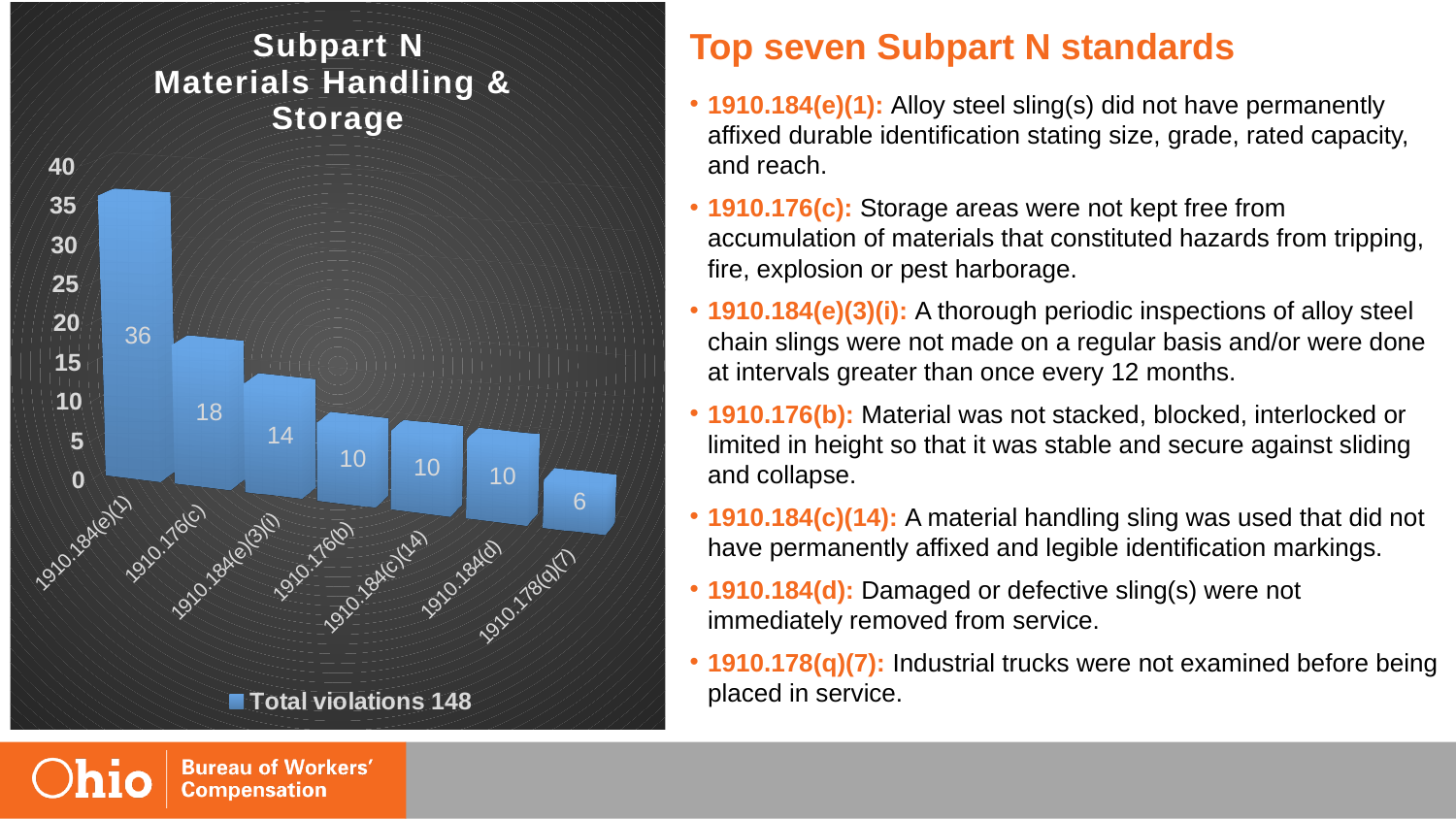
What is the value for 1910.176(c)? 18 Which is larger, the value for 1910.184(e)(3)(i) or the value for 1910.176(b)? 1910.184(e)(3)(i) What is the value for 1910.184(e)(1)? 36 Which category has the lowest value? 1910.178(q)(7) What kind of chart is shown on the slide? Bar chart Which category has the highest value? 1910.184(e)(1) How many categories are shown in the chart? 7 What is the legend entry of the chart? Total violations 148 Do the values rise or fall from left to right along the x axis? Fall How many series does the legend list? 1 What is the difference between the values for 1910.184(e)(1) and 1910.176(c)? 18 What is the value for 1910.178(q)(7)? 6